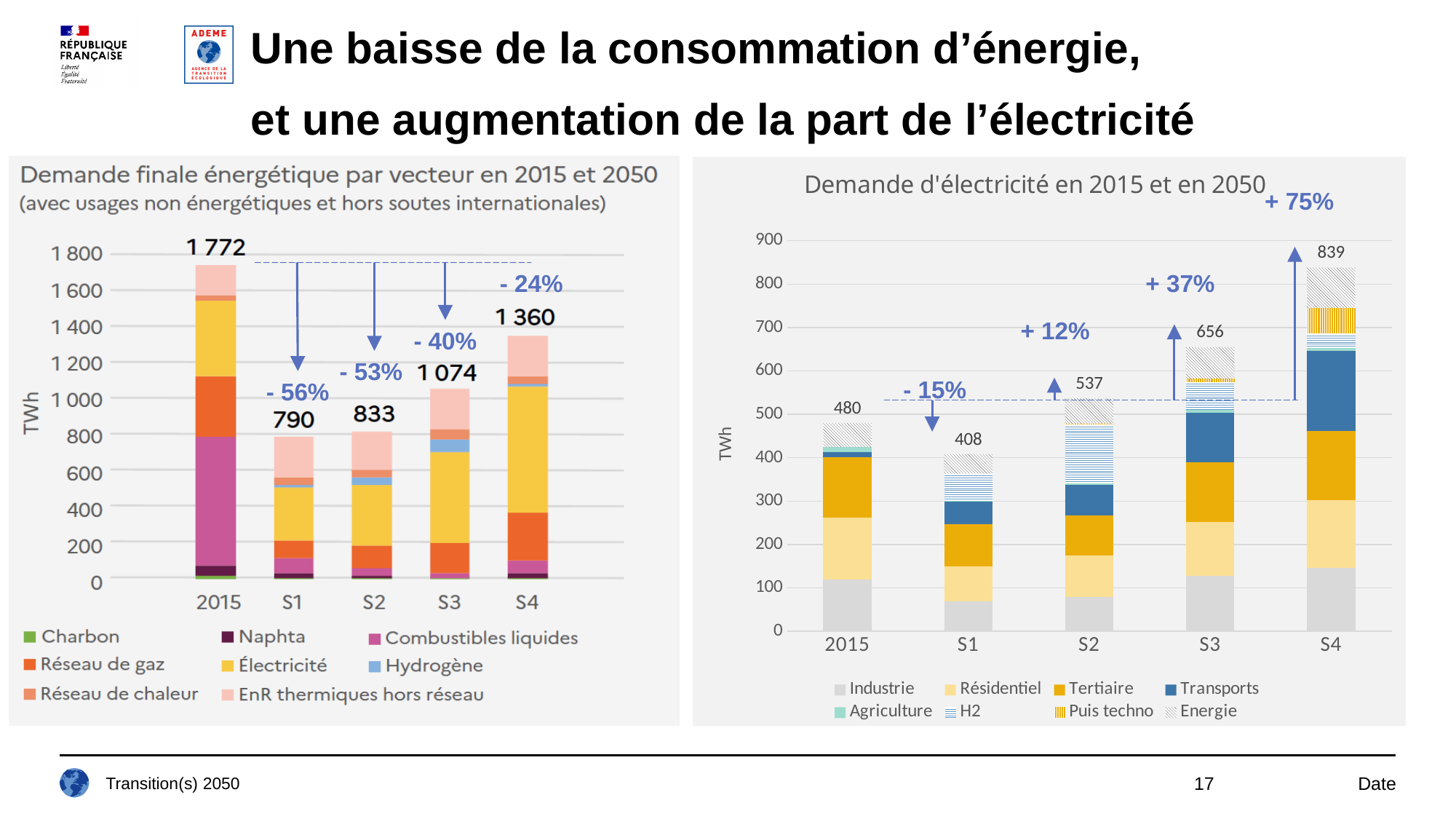
In the chart 'Demande finale énergétique par vecteur en 2015 et 2050', what is the difference between the totals for S4 and S1? 570 In the chart 'Demande finale énergétique par vecteur en 2015 et 2050', what percentage change is shown for S2 relative to 2015? - 53% In the chart 'Demande d'électricité en 2015 et en 2050', what is the difference between the totals for S3 and 2015? 176 In the chart 'Demande d'électricité en 2015 et en 2050', what is the total for S4? 839 In the chart 'Demande finale énergétique par vecteur en 2015 et 2050', what is the total for S3? 1 074 In the chart 'Demande d'électricité en 2015 et en 2050', is the total for S1 larger or smaller than the total for 2015? smaller In the chart 'Demande finale énergétique par vecteur en 2015 et 2050', what is the total for 2015? 1 772 In the chart 'Demande d'électricité en 2015 et en 2050', which scenario has the highest total? S4 In the chart 'Demande finale énergétique par vecteur en 2015 et 2050', which scenario has the lowest total? S1 What kind of chart is 'Demande d'électricité en 2015 et en 2050'? stacked bar chart In the chart 'Demande finale énergétique par vecteur en 2015 et 2050', how many series does the legend list? 8 In the chart 'Demande d'électricité en 2015 et en 2050', how many bars are plotted? 5